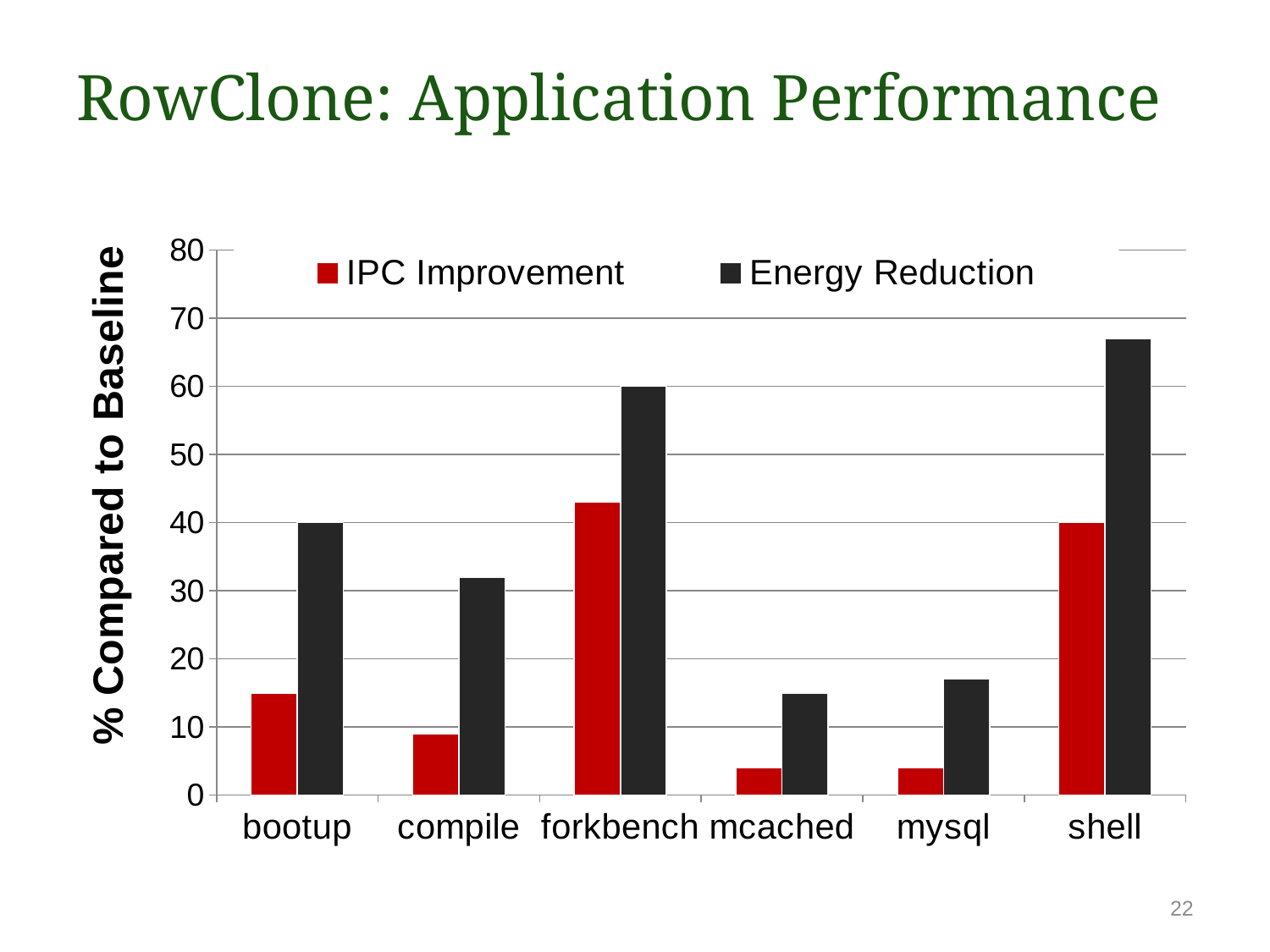
What kind of chart is shown on the slide? bar chart Which application has the highest Energy Reduction? shell Which application has the highest IPC Improvement? forkbench Which is larger, the IPC Improvement for forkbench or the IPC Improvement for bootup? forkbench What is the label of the y axis? % Compared to Baseline Which is larger, the Energy Reduction for bootup or the Energy Reduction for compile? bootup Is the IPC Improvement for mcached greater or less than 10? less How many applications are shown on the x axis? 6 Is the Energy Reduction for forkbench greater or less than 50? greater Is the Energy Reduction for shell greater or less than 60? greater How many series does the legend list? 2